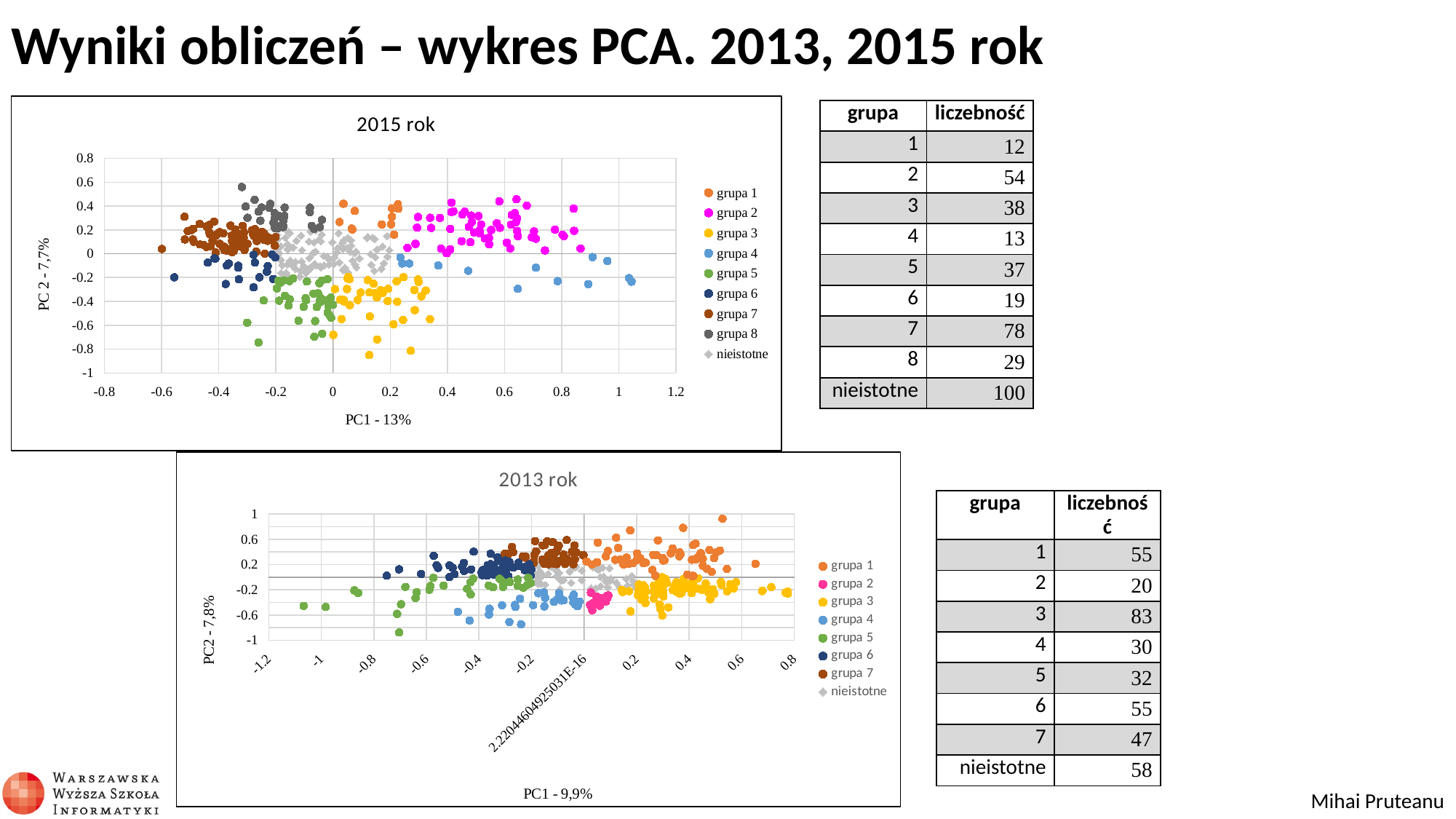
How many series does the legend of the "2015 rok" chart list? 9 What kind of chart is the "2015 rok" chart? scatter chart What kind of chart is the "2013 rok" chart? scatter chart In the "2015 rok" chart, which group has the point lying furthest to the right along PC1? grupa 4 How many series does the legend of the "2013 rok" chart list? 8 How many charts are shown on the slide? 2 In the "2015 rok" chart, which group has the point lying furthest to the left along PC1? grupa 7 In the "2013 rok" chart, which group has the points lying furthest to the left along PC1? grupa 5 In the "2013 rok" chart, which legend entry is shown with diamond-shaped markers? nieistotne What is the x-axis title of the "2015 rok" chart? PC1 - 13% In the "2015 rok" chart, do the grupa 2 points lie at PC1 values greater or less than 0.2? greater In the "2013 rok" chart, do the grupa 6 points lie at PC1 values greater or less than 0? less